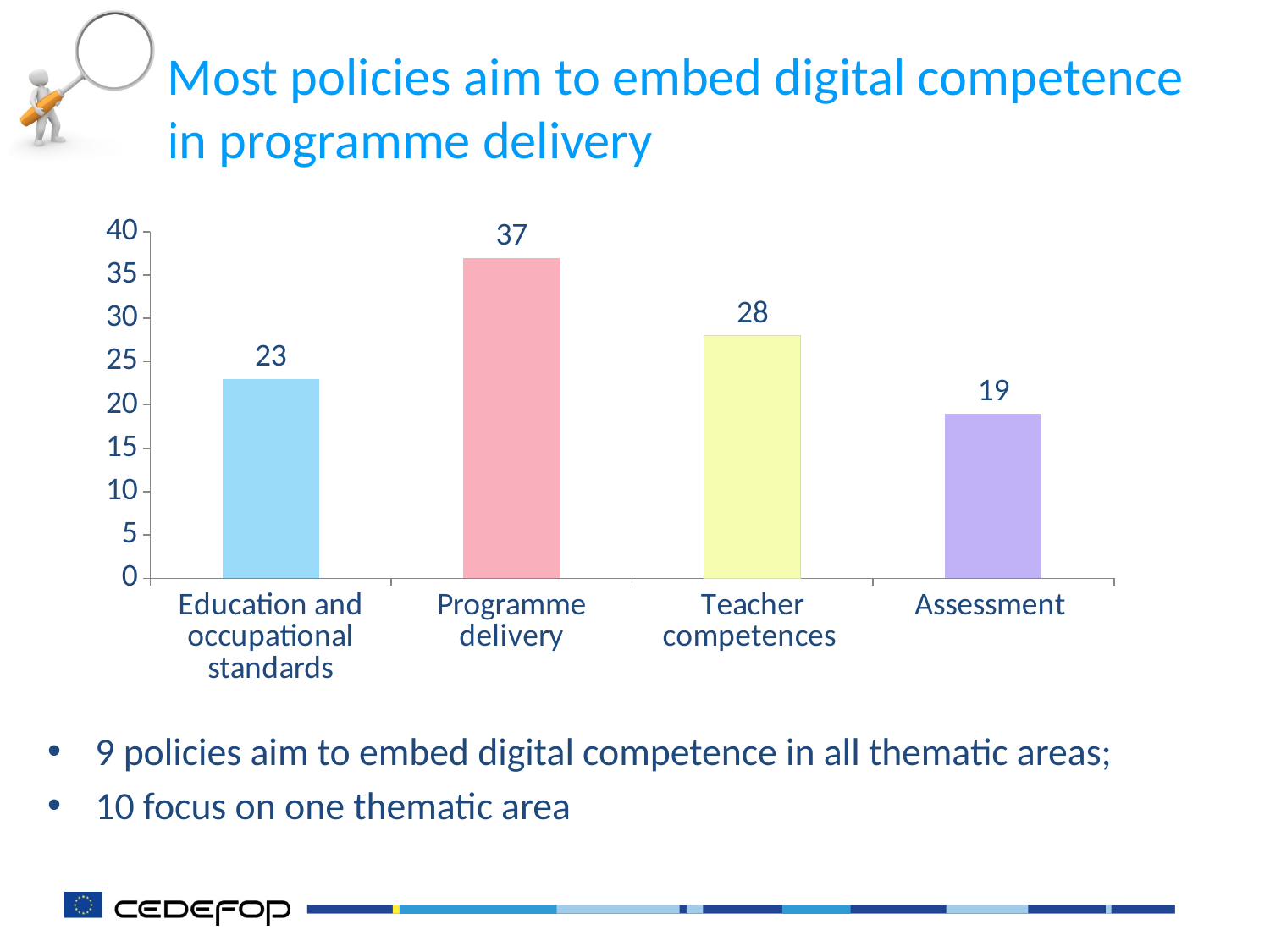
Is the value for Assessment greater or less than 20? less What is the value for Assessment? 19 Which category has the lowest value? Assessment What is the value for Teacher competences? 28 What is the value for Programme delivery? 37 What is the difference between the values for Programme delivery and Assessment? 18 Which is larger, the value for Teacher competences or the value for Education and occupational standards? Teacher competences What kind of chart is shown on the slide? bar chart What is the value for Education and occupational standards? 23 Which category has the highest value? Programme delivery What is the difference between the values for Teacher competences and Education and occupational standards? 5 How many categories are shown in the chart? 4